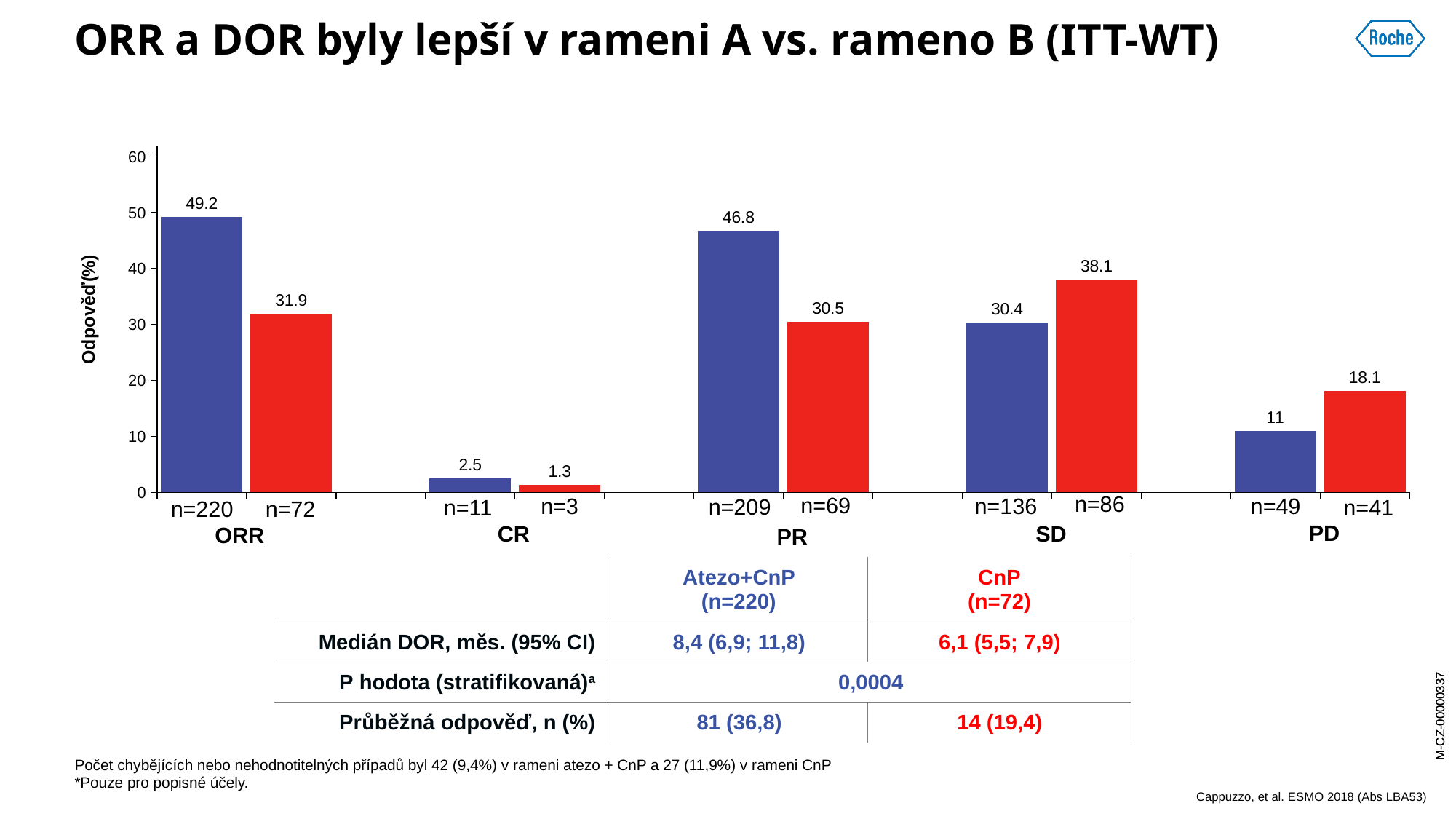
Which category has the lowest value for the red (CnP) bar? CR How many response categories are shown on the x axis of the chart? 5 Is the value of the blue (Atezo+CnP) bar for PR greater or less than 40? greater What is the difference between the blue and red bars for ORR? 17.3 What is the ORR value for the blue (Atezo+CnP) bar? 49.2 What type of chart is shown on the slide? bar chart For SD, which bar is larger, the blue (Atezo+CnP) or the red (CnP)? red (CnP) What is the PD value for the blue (Atezo+CnP) bar? 11 What is the label of the y axis of the chart? Odpověď (%) What is the PR value for the red (CnP) bar? 30.5 What is the ORR value for the red (CnP) bar? 31.9 Which category has the highest value for the blue (Atezo+CnP) bar? ORR